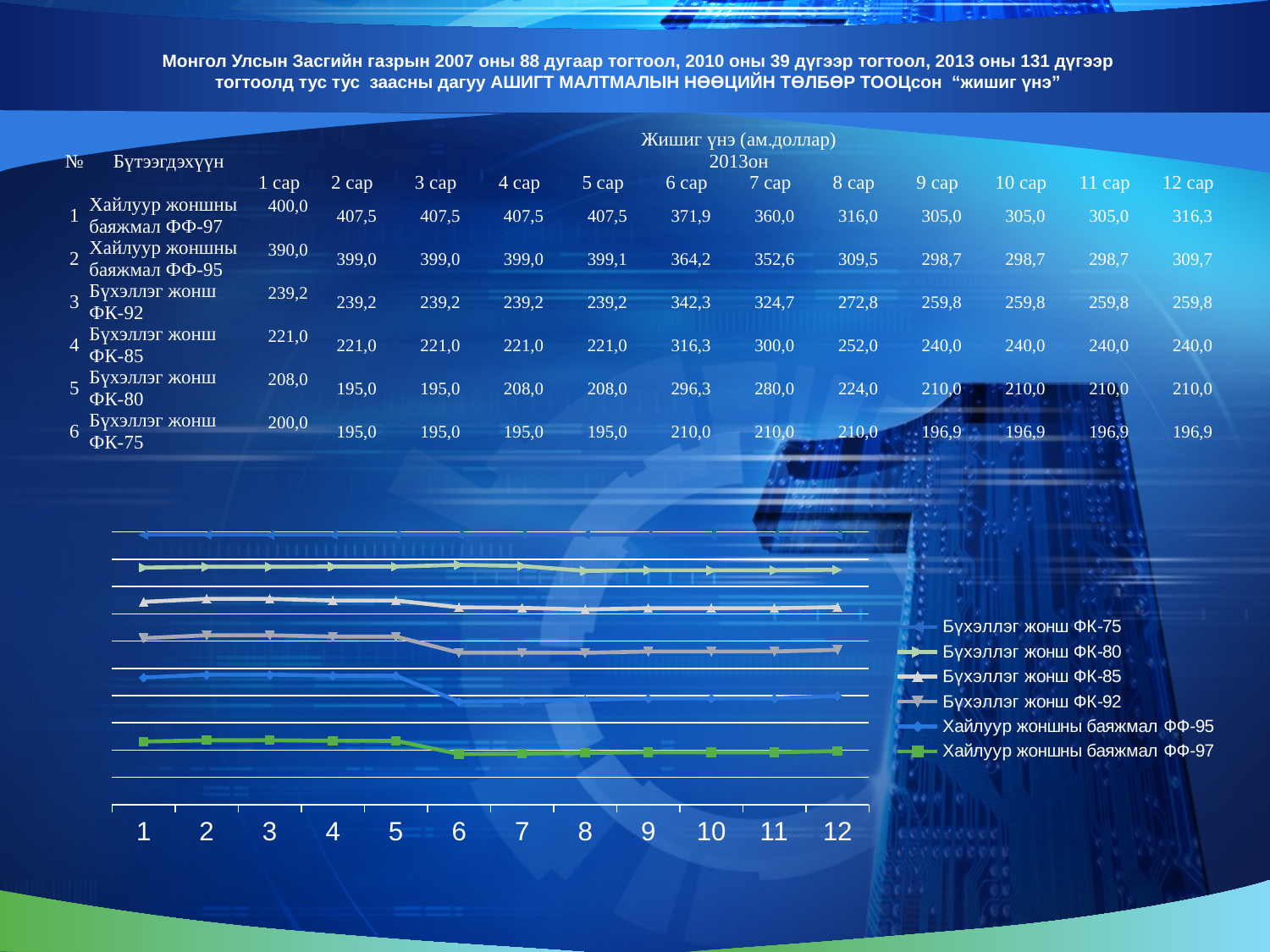
Which legend entry is listed first in the chart's legend? Бүхэллэг жонш ФК-75 What kind of chart is shown on the slide? line chart Does the line for Хайлуур жоншны баяжмал ФФ-97 go up or down between point 5 and point 6 on the x axis? down How many series does the chart's legend list? 6 What is the last value shown on the chart's x axis? 12 Does the line for Хайлуур жоншны баяжмал ФФ-95 go up or down between point 5 and point 6 on the x axis? down How many points are marked along the x axis of the chart? 12 What is the first value shown on the chart's x axis? 1